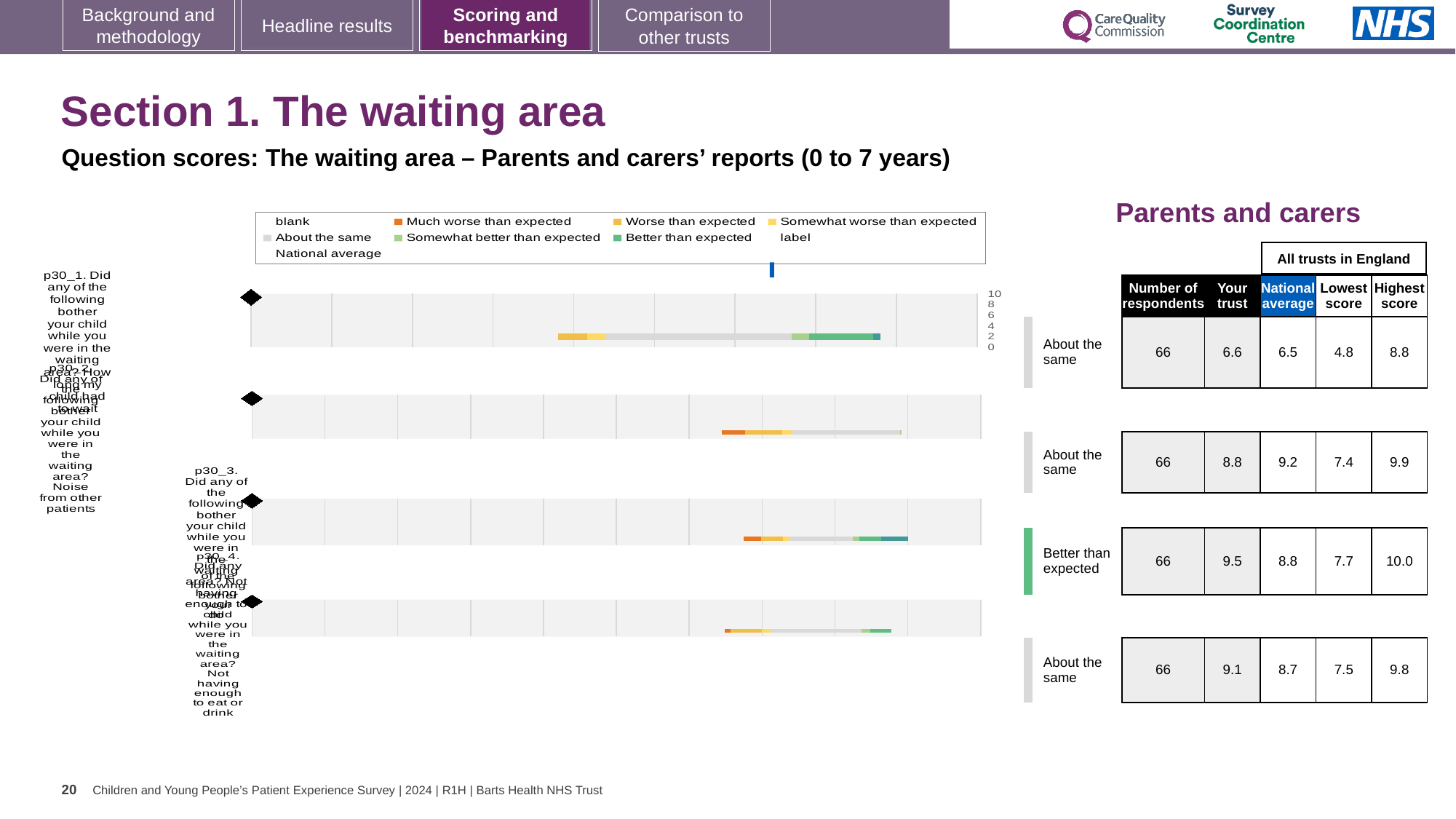
What kind of chart is used to show the question scores for the waiting area? bar chart In the table beside the chart, how many respondents answered p30_1 (How long my child had to wait)? 66 How many entries does the legend of the waiting area chart list? 9 In the table beside the chart, which question has the highest 'Your trust' score? p30_3 (Not having enough to do) In the table beside the chart, what is the 'Your trust' score for p30_3 (Not having enough to do)? 9.5 In the table beside the chart, what is the difference between the 'Your trust' score and the national average for p30_3 (Not having enough to do)? 0.7 In the table beside the chart, which question has the lowest 'Your trust' score? p30_1 (How long my child had to wait) In the table beside the chart, is the 'Your trust' score or the national average larger for p30_2 (Noise from other patients)? National average In the table beside the chart, what is the national average for p30_2 (Noise from other patients)? 9.2 What is the first entry listed in the legend of the waiting area chart? blank How many questions (bars) are plotted in the waiting area chart? 4 In the legend of the waiting area chart, what colour represents 'Much worse than expected'? orange